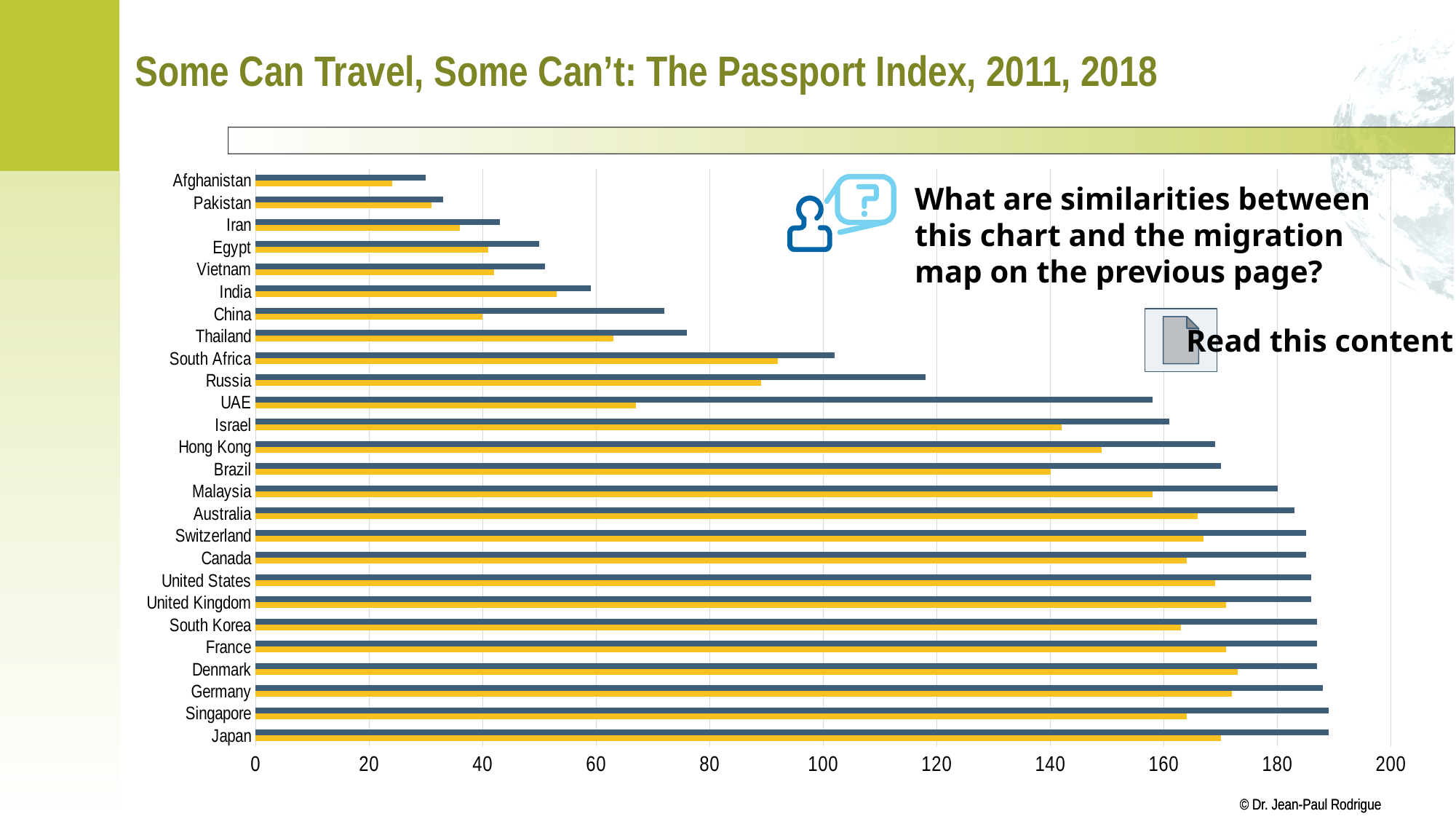
Is the dark blue bar for China greater or less than 60? greater What is the title of the slide containing the chart? Some Can Travel, Some Can't: The Passport Index, 2011, 2018 Is the yellow bar for UAE greater or less than 80? less Is the dark blue bar for Afghanistan greater or less than 40? less How many bars are shown for each country? 2 What kind of chart is shown on the slide? bar chart How many countries are listed on the chart? 26 Do the bar lengths generally increase or decrease going down the list from Afghanistan to Japan? increase Which country has the shortest bars on the chart? Afghanistan Which has the longer dark blue bar, Russia or South Africa? Russia